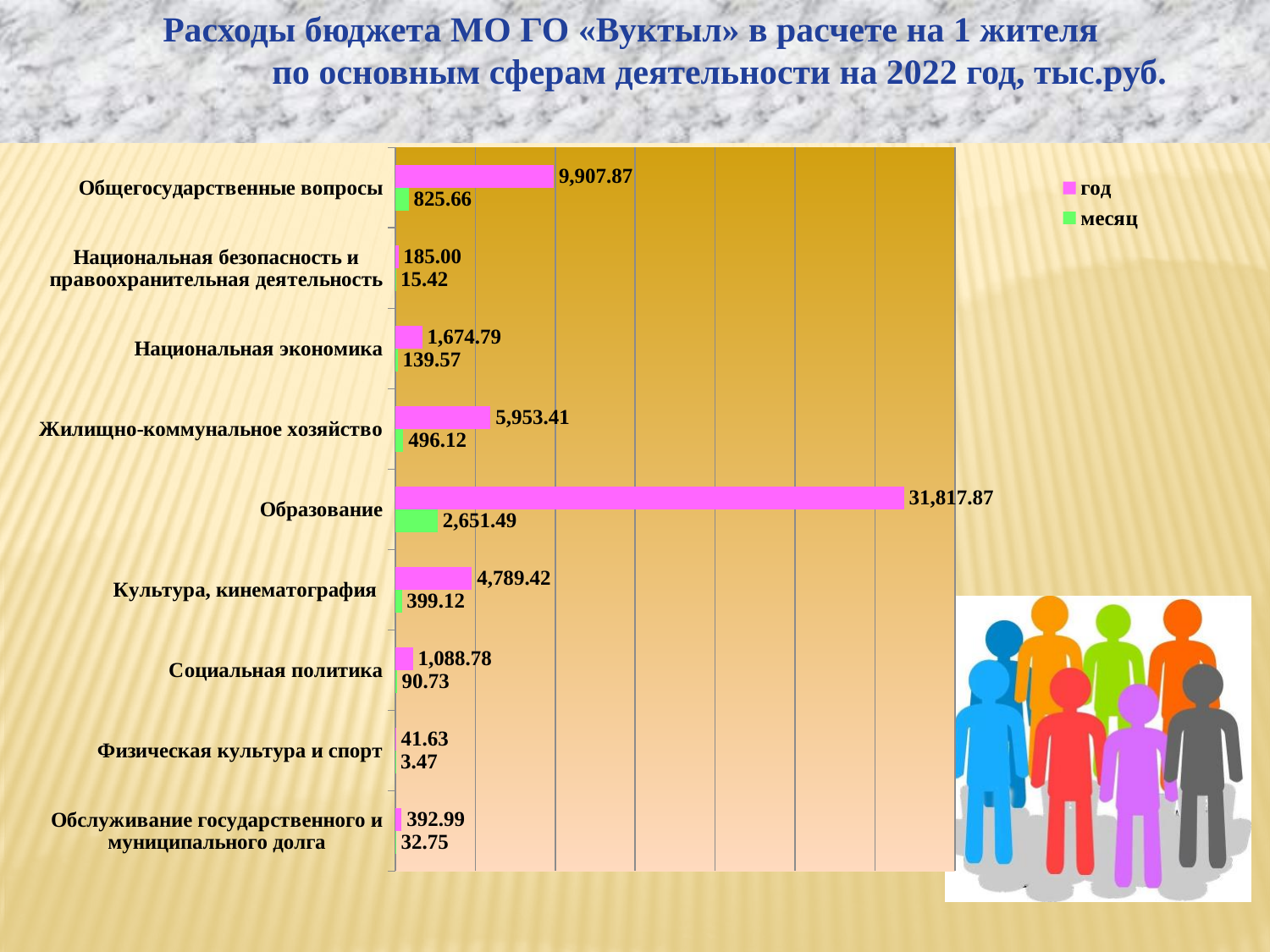
Which is larger, the "год" value for Национальная экономика or for Социальная политика? Национальная экономика What kind of chart is shown on the slide? Bar chart How many categories are shown on the chart? 9 Which colour represents the "месяц" series in the legend? Green How many series does the legend list? 2 What is the value for "месяц" for Жилищно-коммунальное хозяйство? 496.12 What is the value for "год" for Образование? 31,817.87 What is the value for "год" for Культура, кинематография? 4,789.42 Which category has the highest value for "год"? Образование What is the value for "месяц" for Физическая культура и спорт? 3.47 What is the difference between the "год" values for Общегосударственные вопросы and Жилищно-коммунальное хозяйство? 3,954.46 Which category has the lowest value for "месяц"? Физическая культура и спорт